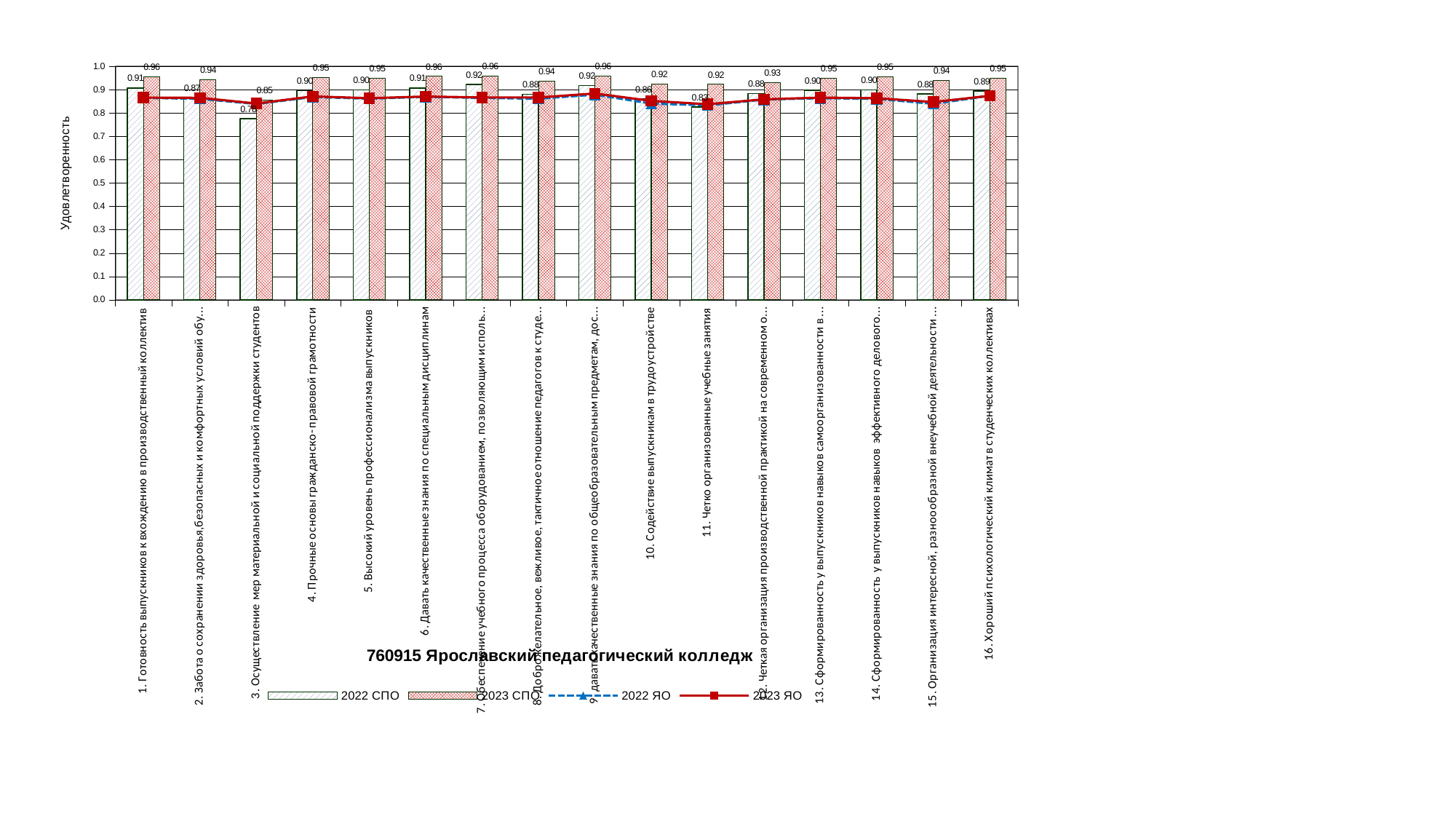
What is the 2023 СПО value for category 10 (Содействие выпускникам в трудоустройстве)? 0.92 What is the 2022 СПО value for category 11 (Четко организованные учебные занятия)? 0.83 What is the 2023 СПО value for category 16 (Хороший психологический климат в студенческих коллективах)? 0.95 What is the title of the chart? 760915 Ярославский педагогический колледж How many series does the legend list? 4 Is the 2022 СПО value for category 3 (Осуществление мер материальной и социальной поддержки студентов) greater or less than 0.9? less For category 10 (Содействие выпускникам в трудоустройстве), which is larger: the 2022 СПО value or the 2023 СПО value? 2023 СПО What is the label of the y axis? Удовлетворенность How many categories are shown on the x axis? 16 What is the difference between the 2023 СПО and 2022 СПО values for category 16 (Хороший психологический климат в студенческих коллективах)? 0.06 What is the 2022 СПО value for category 1 (Готовность выпускников к вхождению в производственный коллектив)? 0.91 Which category has the lowest 2023 СПО value? 3. Осуществление мер материальной и социальной поддержки студентов